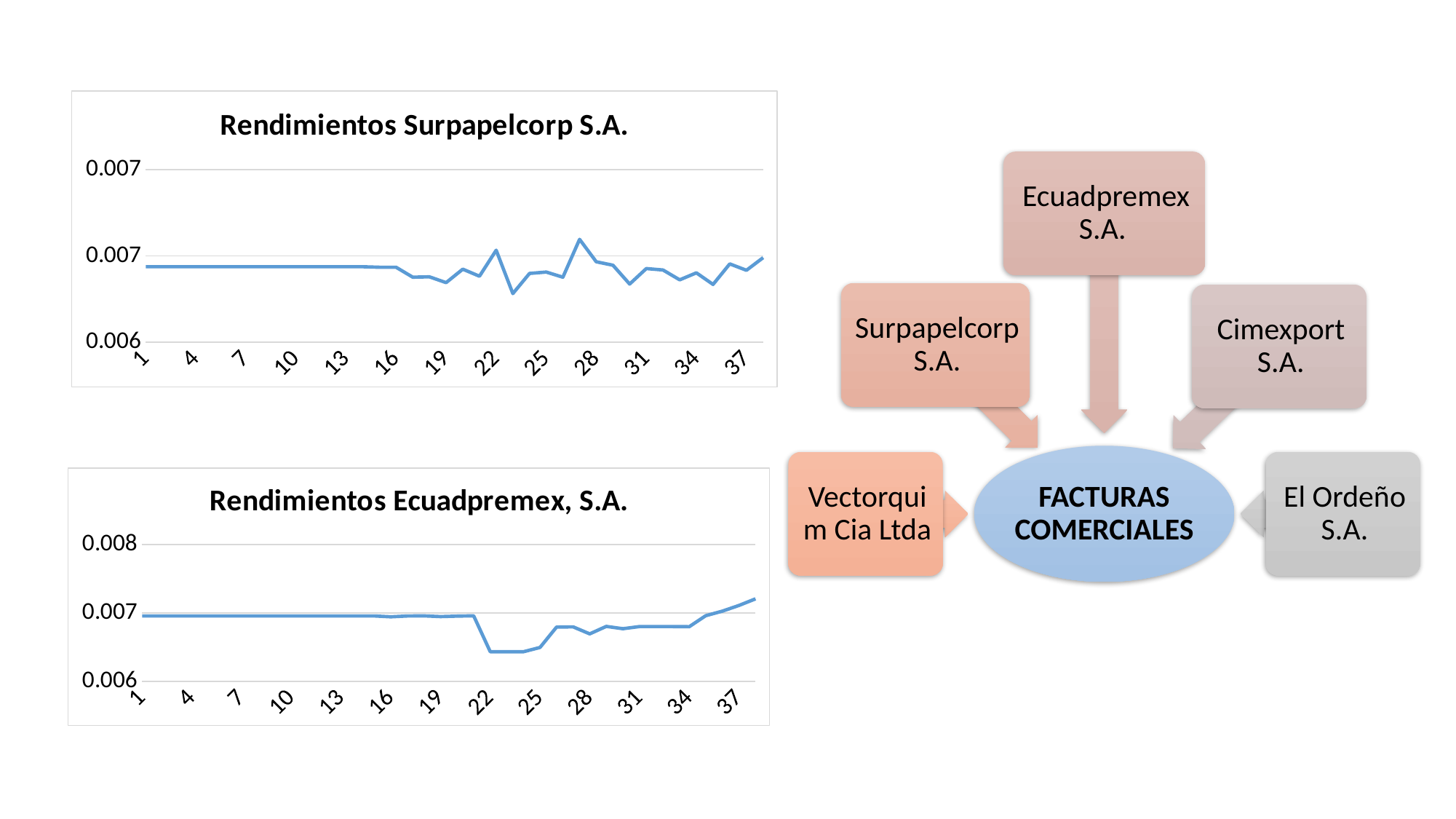
How many charts are shown on the slide? 2 What kind of chart is the 'Rendimientos Surpapelcorp S.A.' chart? line chart What kind of chart is the 'Rendimientos Ecuadpremex, S.A.' chart? line chart In the 'Rendimientos Ecuadpremex, S.A.' chart, do the values rise or fall between point 19 and point 23? fall In the 'Rendimientos Ecuadpremex, S.A.' chart, is the value at the last point on the right greater or less than 0.007? greater In the 'Rendimientos Ecuadpremex, S.A.' chart, do the values rise or fall between point 31 and the last point? rise In the 'Rendimientos Surpapelcorp S.A.' chart, is the value at point 1 greater or less than 0.006? greater In the 'Rendimientos Ecuadpremex, S.A.' chart, which is larger: the value at point 1 or the value at point 23? point 1 In the 'Rendimientos Surpapelcorp S.A.' chart, which is larger: the value at point 23 or the value at point 28? point 28 In the 'Rendimientos Ecuadpremex, S.A.' chart, is the value at point 23 greater or less than 0.007? less What is the title of the lower chart on the slide? Rendimientos Ecuadpremex, S.A.